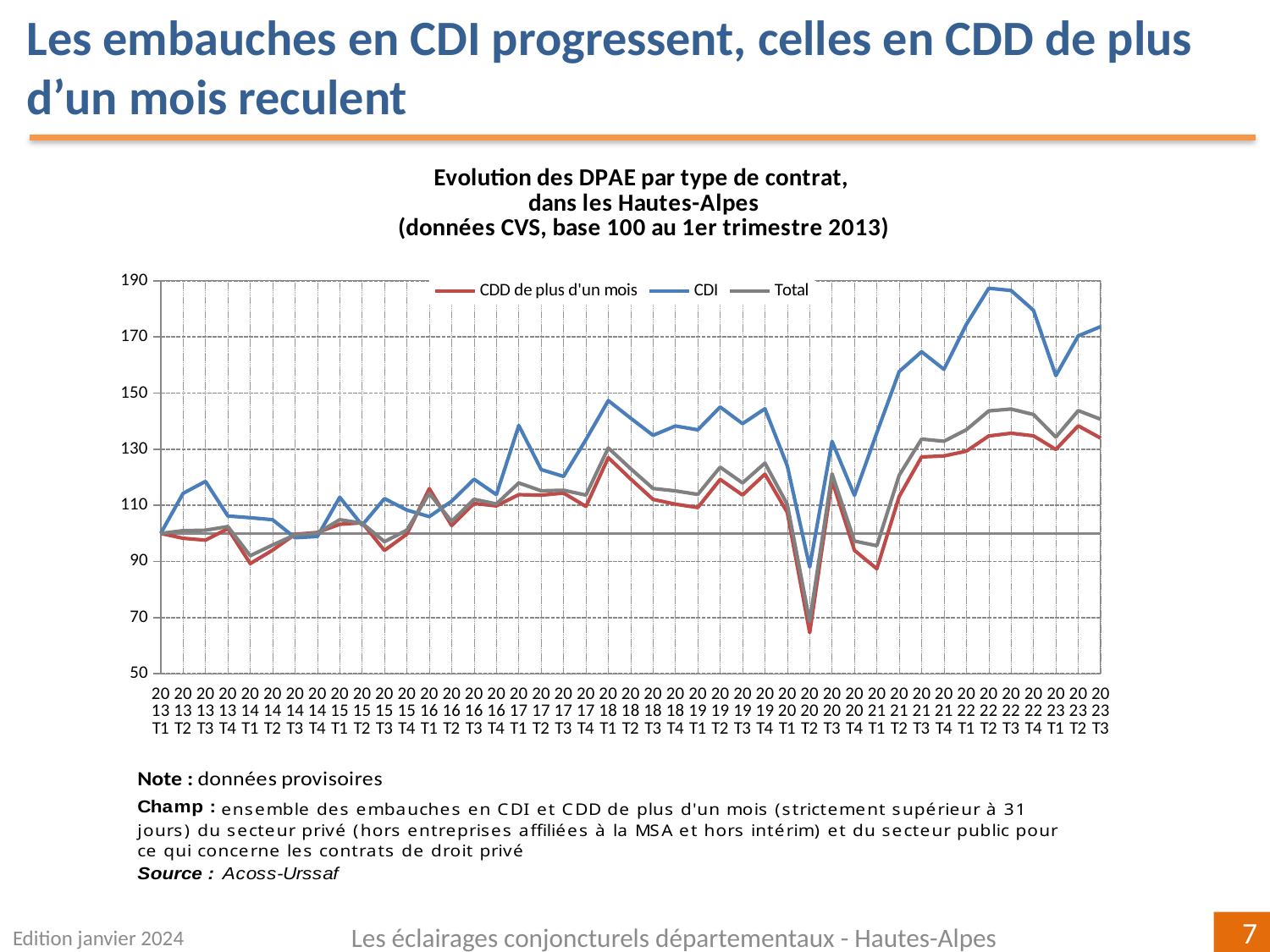
At which quarter does the CDI series reach its lowest point? 2020 T2 Which series has the lowest value at 2020 T2? CDD de plus d'un mois Is the value of the CDI series at 2022 T2 greater or less than 170? greater Is the value of the Total series at 2023 T3 greater or less than 130? greater Which series has the highest value at 2023 T3? CDI Is the value of the 'CDD de plus d'un mois' series at 2020 T2 greater or less than 70? less What kind of chart is shown on the slide? line chart What colour is the line for the CDI series? blue Does the CDI series rise or fall between 2021 T1 and 2022 T2? rise How many series does the legend list? 3 How many quarterly points are plotted along the x axis, from 2013 T1 to 2023 T3? 43